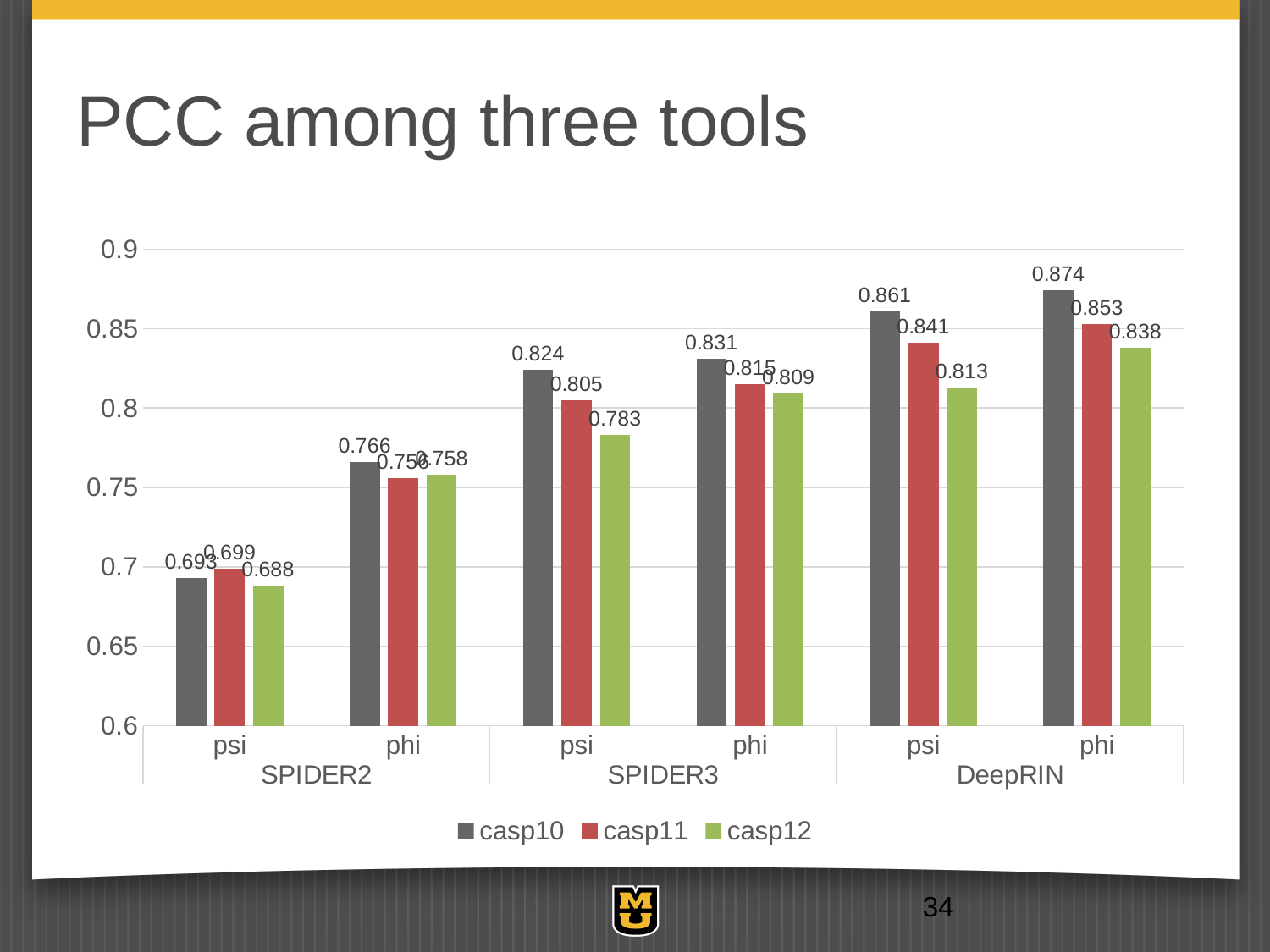
What is the casp12 value for SPIDER3 psi? 0.783 Is the casp10 value for SPIDER3 psi greater or less than 0.8? greater For casp12, which is larger: SPIDER3 psi or SPIDER3 phi? SPIDER3 phi What is the casp11 value for DeepRIN psi? 0.841 What is the casp10 value for DeepRIN phi? 0.874 How many psi/phi category groups are shown on the x axis? 6 What is the difference between the casp10 and casp12 values for DeepRIN psi? 0.048 Do the casp10 values generally rise or fall from SPIDER2 psi to DeepRIN phi? rise What kind of chart is shown on the slide? bar chart How many series does the legend list? 3 Which tool and angle has the lowest casp12 value? SPIDER2 psi Which tool and angle has the highest casp10 value? DeepRIN phi